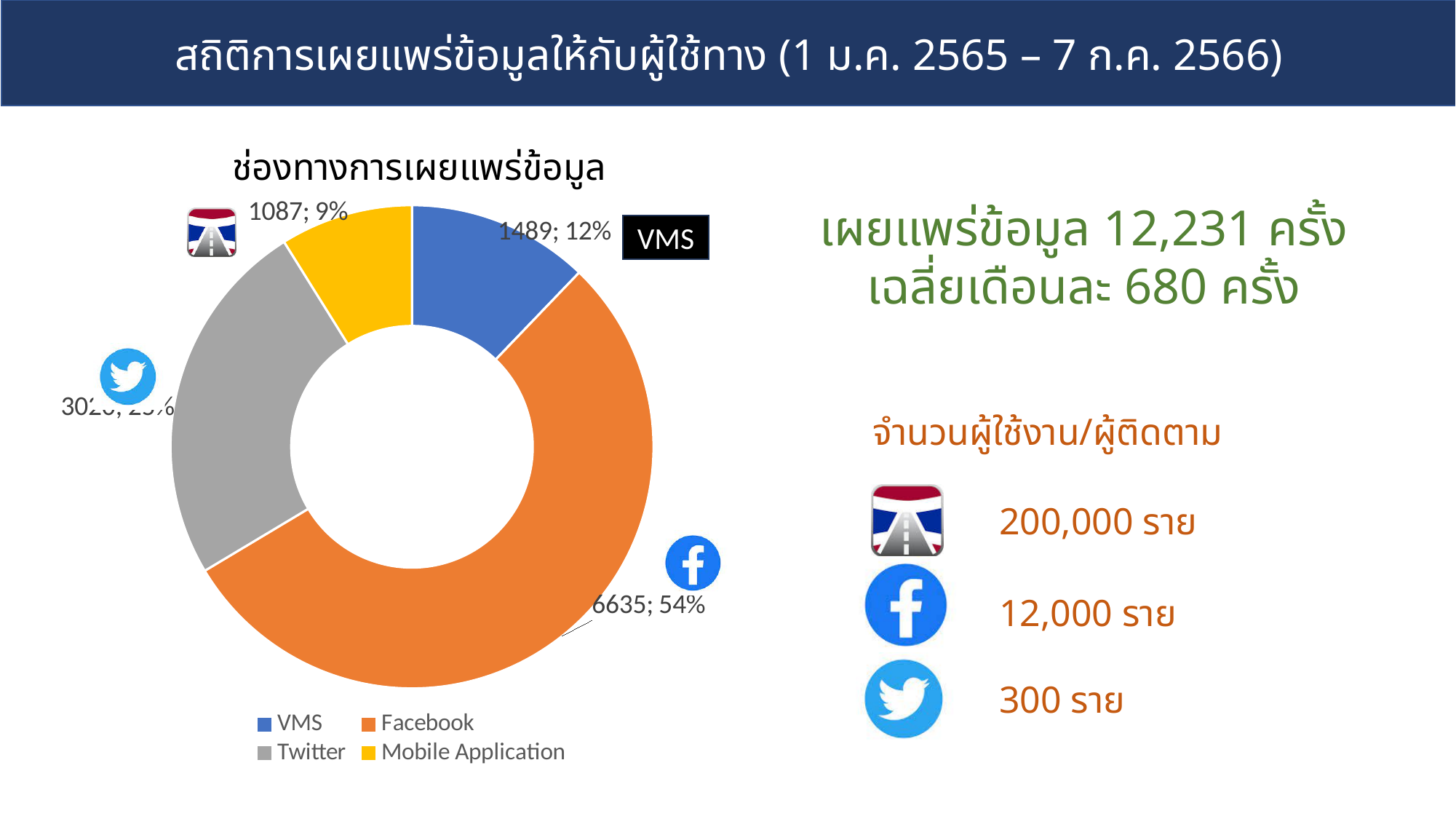
What is the value shown for Mobile Application in the doughnut chart? 1087 What is the difference between the VMS value and the Mobile Application value? 402 What colour represents Facebook in the doughnut chart? orange What is the value shown for VMS in the doughnut chart? 1489 Which is larger, the value for VMS or the value for Mobile Application? VMS What percentage share does VMS have in the doughnut chart? 12% Which category has the largest share of the doughnut chart? Facebook What is the value shown for Facebook in the doughnut chart? 6635 What kind of chart is shown on the slide? doughnut chart What percentage share does Facebook have in the doughnut chart? 54% Which category has the smallest share of the doughnut chart? Mobile Application How many categories does the doughnut chart show? 4